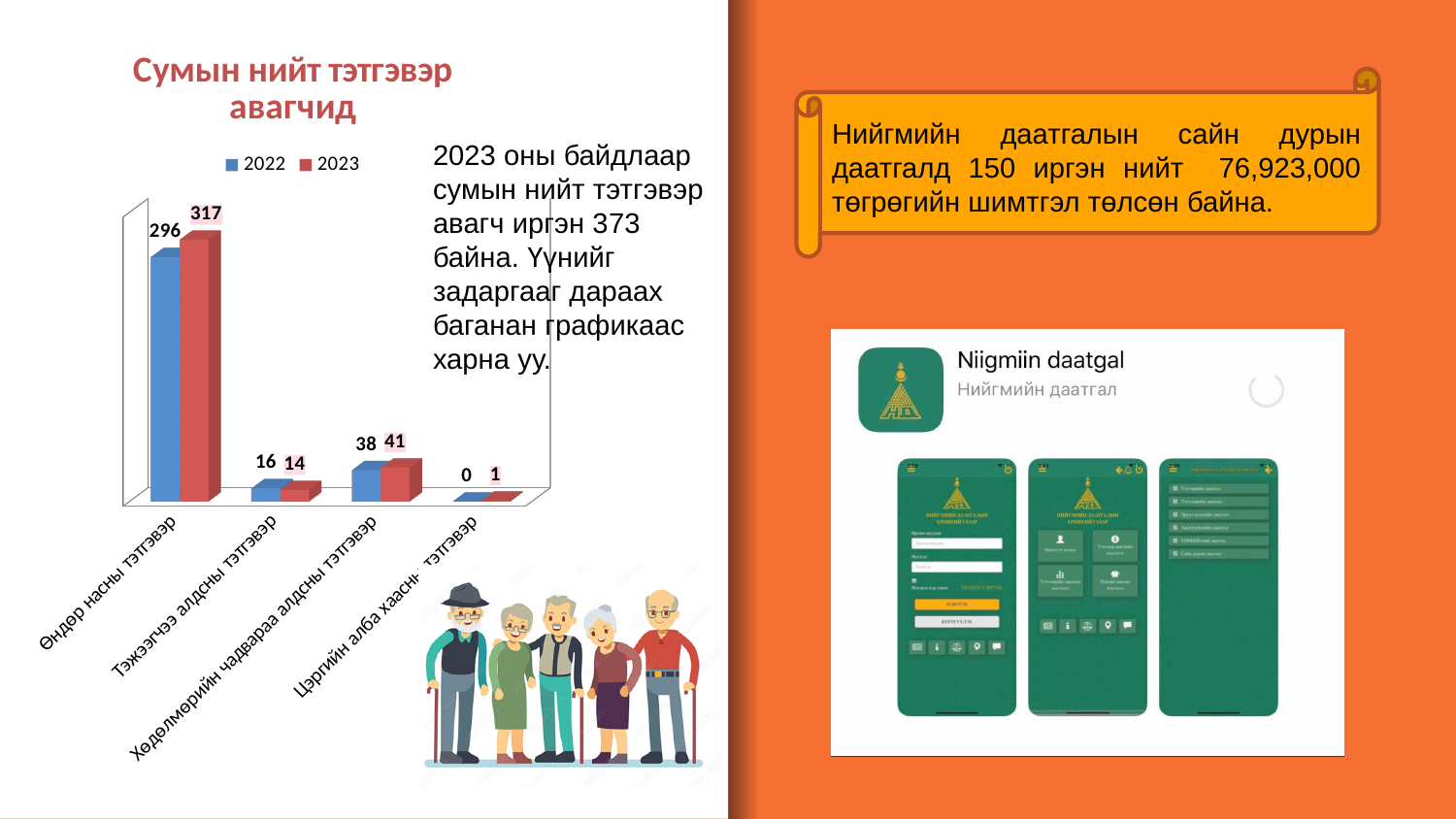
What is the 2023 value for Хөдөлмөрийн чадвараа алдсны тэтгэвэр? 41 What is the 2022 value for Өндөр насны тэтгэвэр in the chart? 296 For Тэжээгчээ алдсны тэтгэвэр, which year has the larger value, 2022 or 2023? 2022 What is the difference between the 2023 and 2022 values for Өндөр насны тэтгэвэр? 21 How many categories are shown on the x axis of the chart? 4 Which category has the highest 2023 value in the chart? Өндөр насны тэтгэвэр What is the 2022 value for Тэжээгчээ алдсны тэтгэвэр? 16 What is the 2023 value for Өндөр насны тэтгэвэр in the chart? 317 Which category has the lowest 2022 value in the chart? Цэргийн алба хаасны тэтгэвэр How many series does the chart legend list? 2 What is the title of the chart on the slide? Сумын нийт тэтгэвэр авагчид What type of chart is shown on the slide? Bar chart